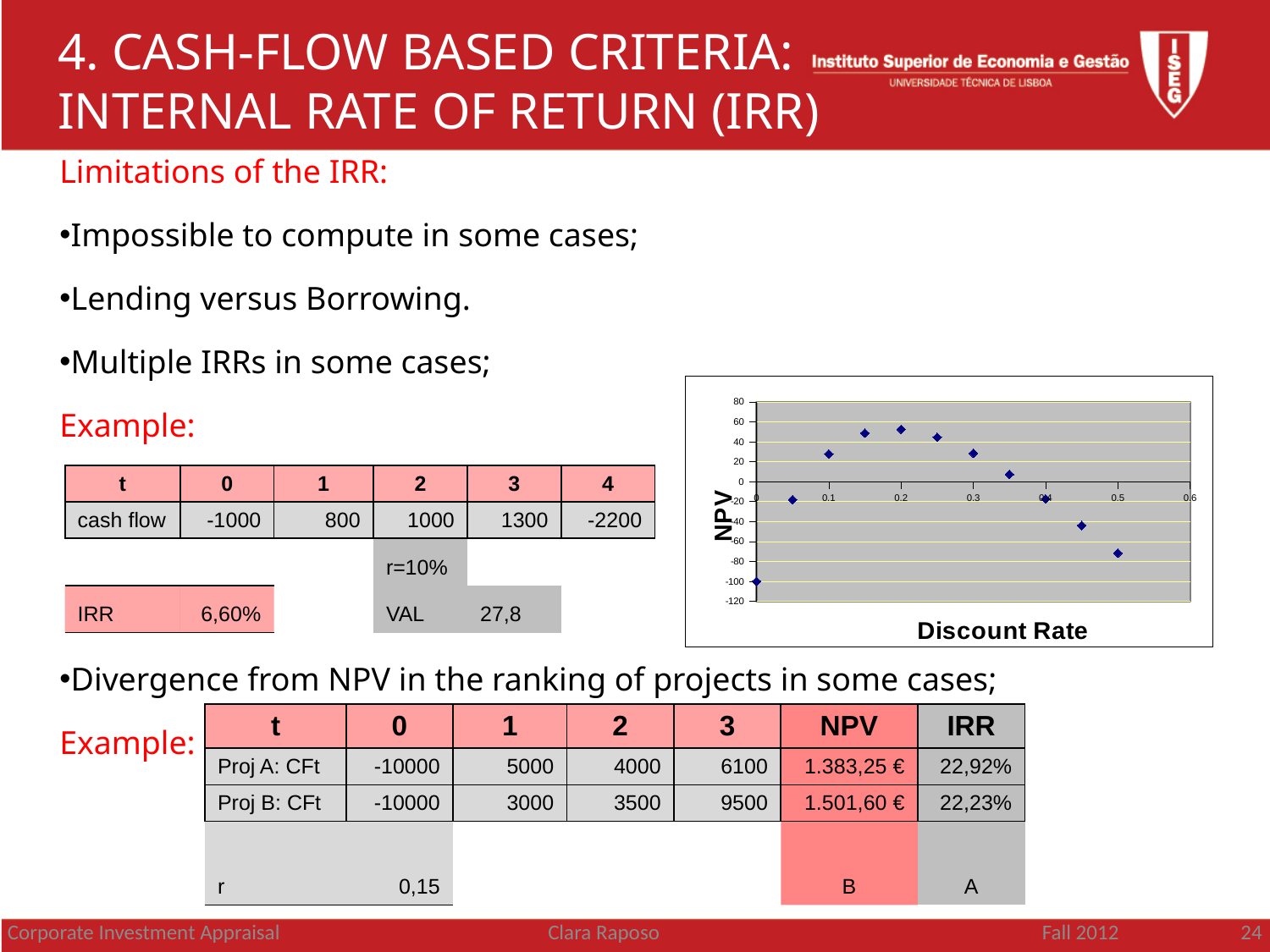
Is the NPV value at a discount rate of 0.45 greater or less than -20? less At which discount rate is the plotted NPV lowest? 0 Which has the larger NPV in the chart: the point at discount rate 0.1 or the point at discount rate 0.5? 0.1 Do the NPV values rise or fall as the discount rate increases from 0 to 0.2? rise What kind of chart is shown on the slide? scatter chart How many data points are plotted in the chart? 11 Is the NPV value at a discount rate of 0.2 greater or less than 40? greater Is the NPV value at a discount rate of 0.5 greater or less than -60? less What is the title of the horizontal axis of the chart? Discount Rate Do the NPV values rise or fall as the discount rate increases from 0.2 to 0.5? fall What is the title of the vertical axis of the chart? NPV